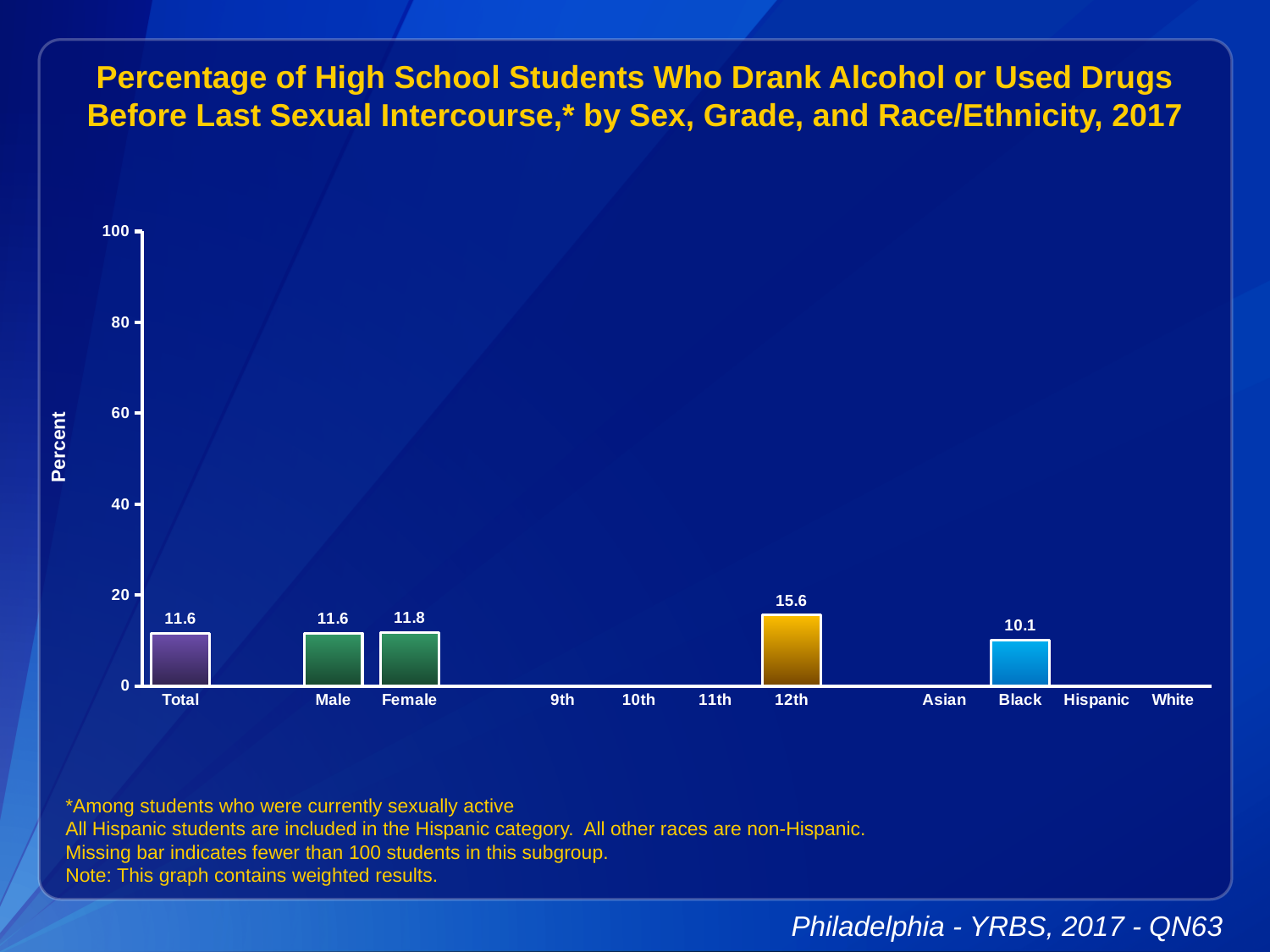
What is the value for Female? 11.8 What kind of chart is shown on the slide? bar chart What is the difference between the values for 12th grade and Black students? 5.5 Which is larger, the value for 12th grade or the value for Total? 12th What is the difference between the values for Female and Male? 0.2 Which category has the highest value? 12th What is the value for 12th grade? 15.6 What is the value for Black students? 10.1 Which category with a bar has the lowest value? Black What is the label of the y axis? Percent Is the value for 12th grade greater or less than 20? less What is the value for Total? 11.6